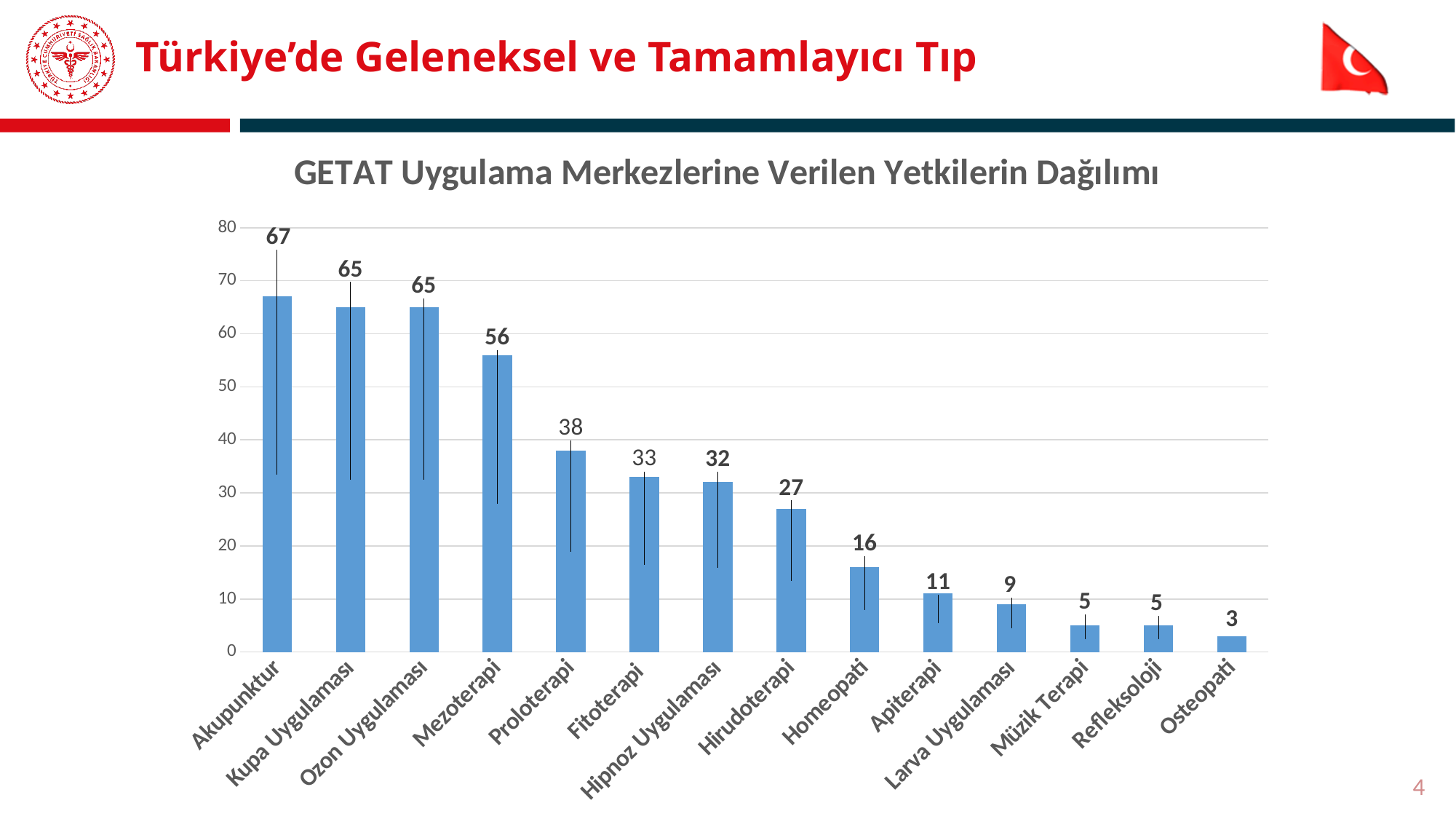
How many categories are shown on the x axis? 14 What is the difference between the values for Proloterapi and Fitoterapi? 5 Do the values rise or fall from left to right along the x axis? Fall Which category has the lowest value? Osteopati What is the value for Hirudoterapi? 27 What is the value for Mezoterapi? 56 What is the value for Akupunktur? 67 What is the title of the chart? GETAT Uygulama Merkezlerine Verilen Yetkilerin Dağılımı What kind of chart is shown on the slide? Bar chart Which is larger, the value for Homeopati or the value for Apiterapi? Homeopati Which category has the highest value? Akupunktur What is the value for Larva Uygulaması? 9